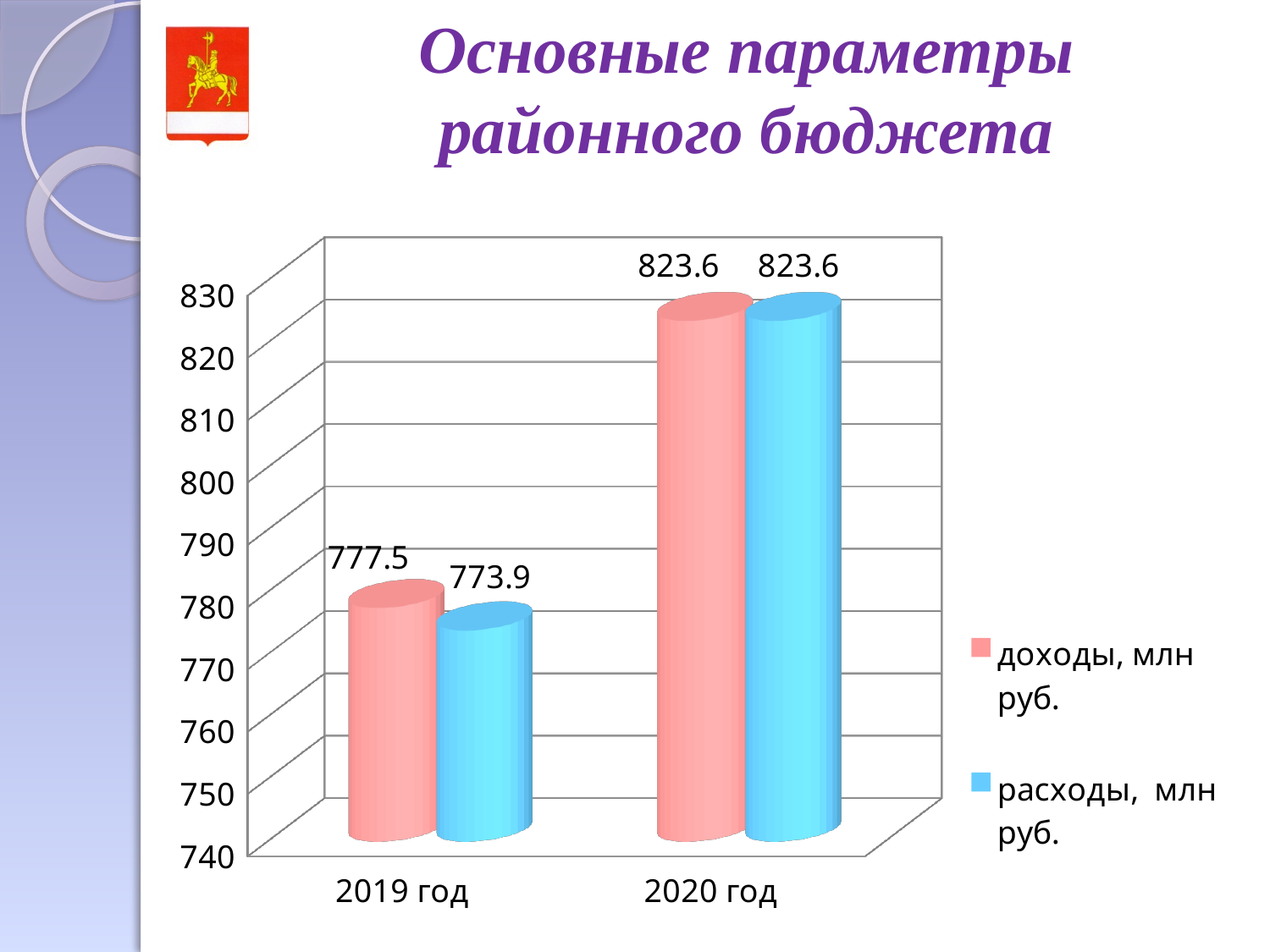
What is the value of доходы, млн руб. for 2020 год? 823.6 What is the value of доходы, млн руб. for 2019 год? 777.5 What kind of chart is shown on the slide? bar chart Which year has the lower value for расходы, млн руб.? 2019 год How many categories (years) are shown on the x axis? 2 What is the difference between доходы and расходы for 2019 год? 3.6 How many series does the legend list? 2 What is the value of расходы, млн руб. for 2019 год? 773.9 What is the difference in доходы, млн руб. between 2020 год and 2019 год? 46.1 What is the value of расходы, млн руб. for 2020 год? 823.6 Which is larger for 2019 год: доходы or расходы? доходы Is the value of расходы, млн руб. for 2020 год greater or less than 800? greater